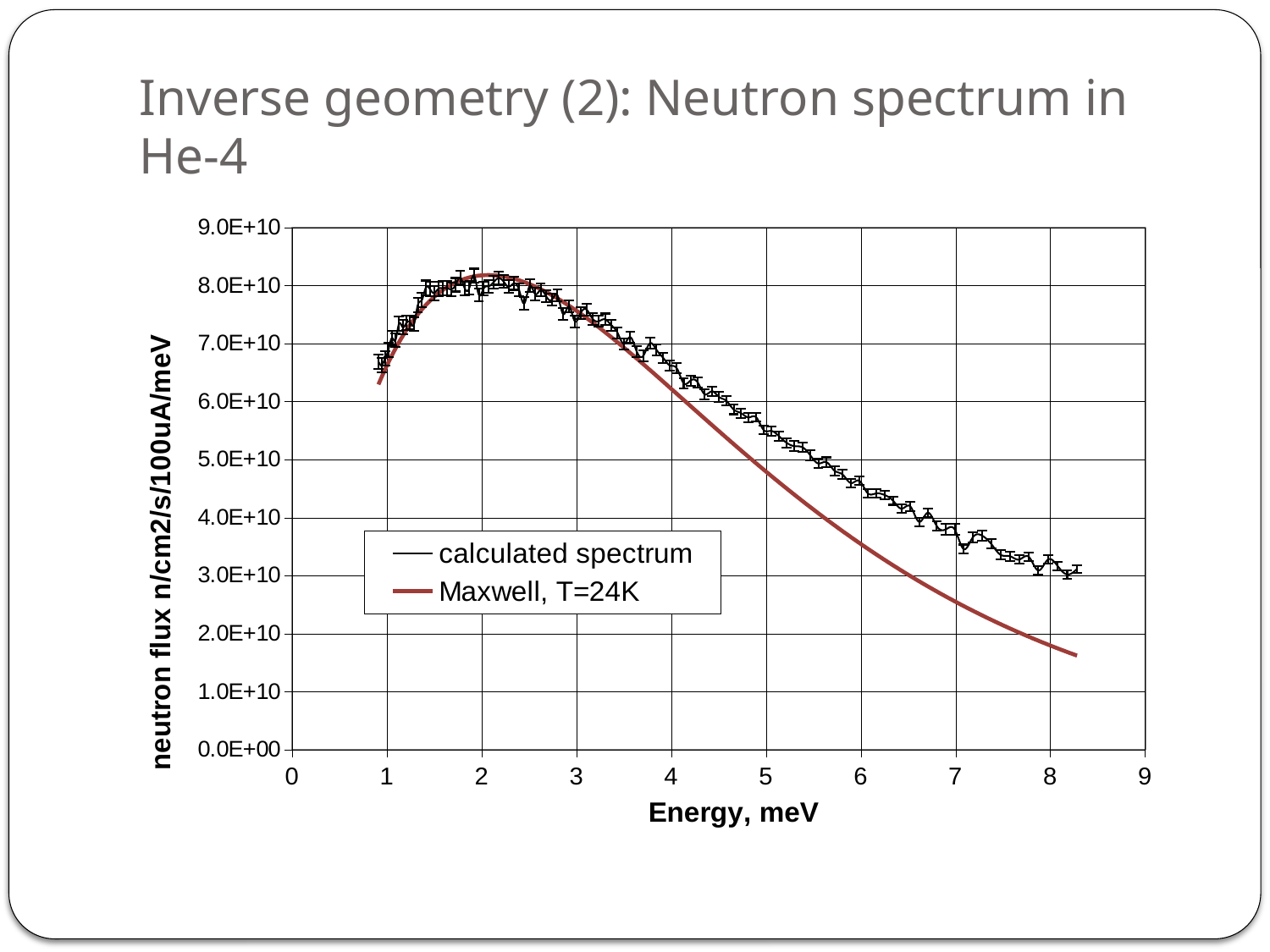
Is the value of the calculated spectrum at 6 meV greater or less than 4.0E+10? greater Is the value of the Maxwell, T=24K curve at 6 meV greater or less than 4.0E+10? less What are the two series named in the legend? calculated spectrum; Maxwell, T=24K Is the value of the calculated spectrum at 5 meV greater or less than 5.0E+10? greater At 8 meV, which series has the lower value: calculated spectrum or Maxwell, T=24K? Maxwell, T=24K At 6 meV, which series has the higher value: calculated spectrum or Maxwell, T=24K? calculated spectrum What is the x-axis title of the chart? Energy, meV Between 3 meV and 8 meV, does the calculated spectrum rise or fall as energy increases? fall What kind of chart is shown on the slide? line chart How many series does the legend list? 2